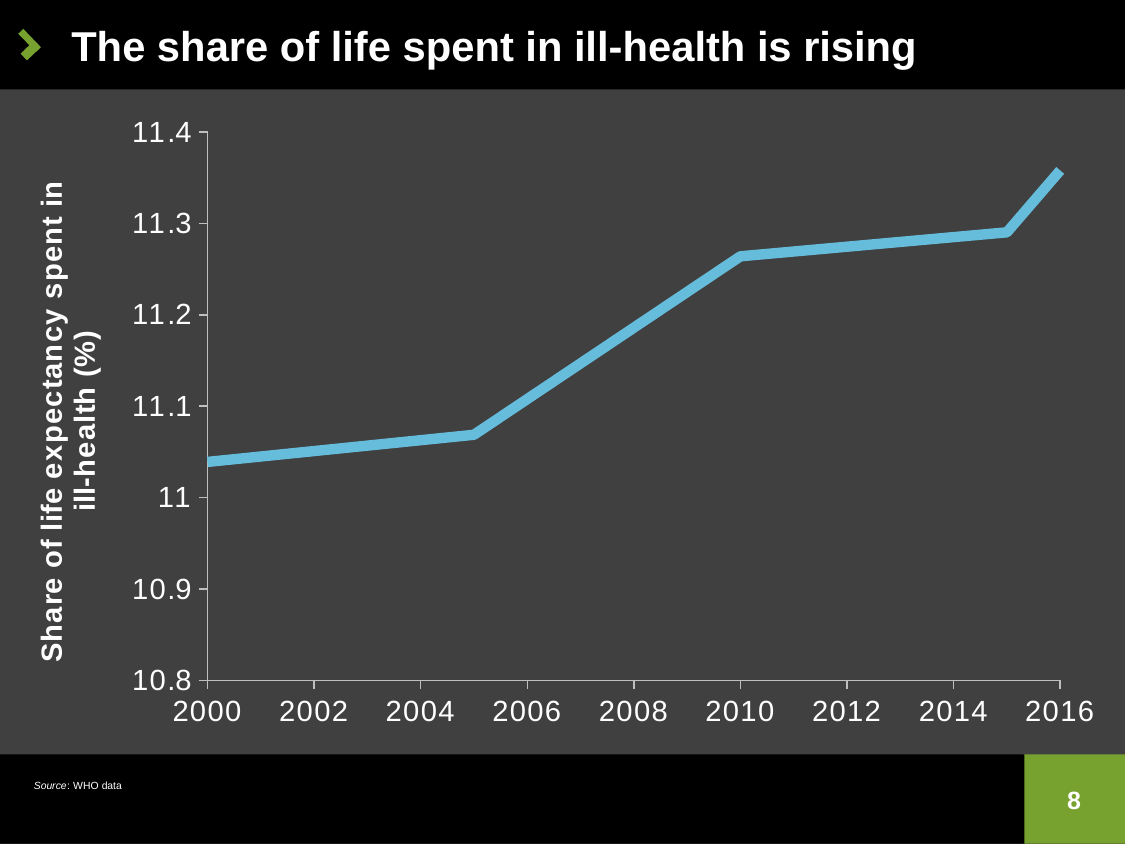
Is the value for 2010 greater or less than 11.2? greater In which year is the share of life expectancy spent in ill-health highest? 2016 What kind of chart is shown on the slide? line chart Which year has a larger share of life expectancy spent in ill-health, 2005 or 2010? 2010 In which year is the share of life expectancy spent in ill-health lowest? 2000 What is the title of the slide? The share of life spent in ill-health is rising Is the value for 2000 greater or less than 11.1? less What is the label on the vertical axis of the chart? Share of life expectancy spent in ill-health (%) Does the share of life expectancy spent in ill-health rise or fall from 2000 to 2016? rise Which year has a larger share of life expectancy spent in ill-health, 2000 or 2016? 2016 Is the value for 2005 greater or less than 11.1? less